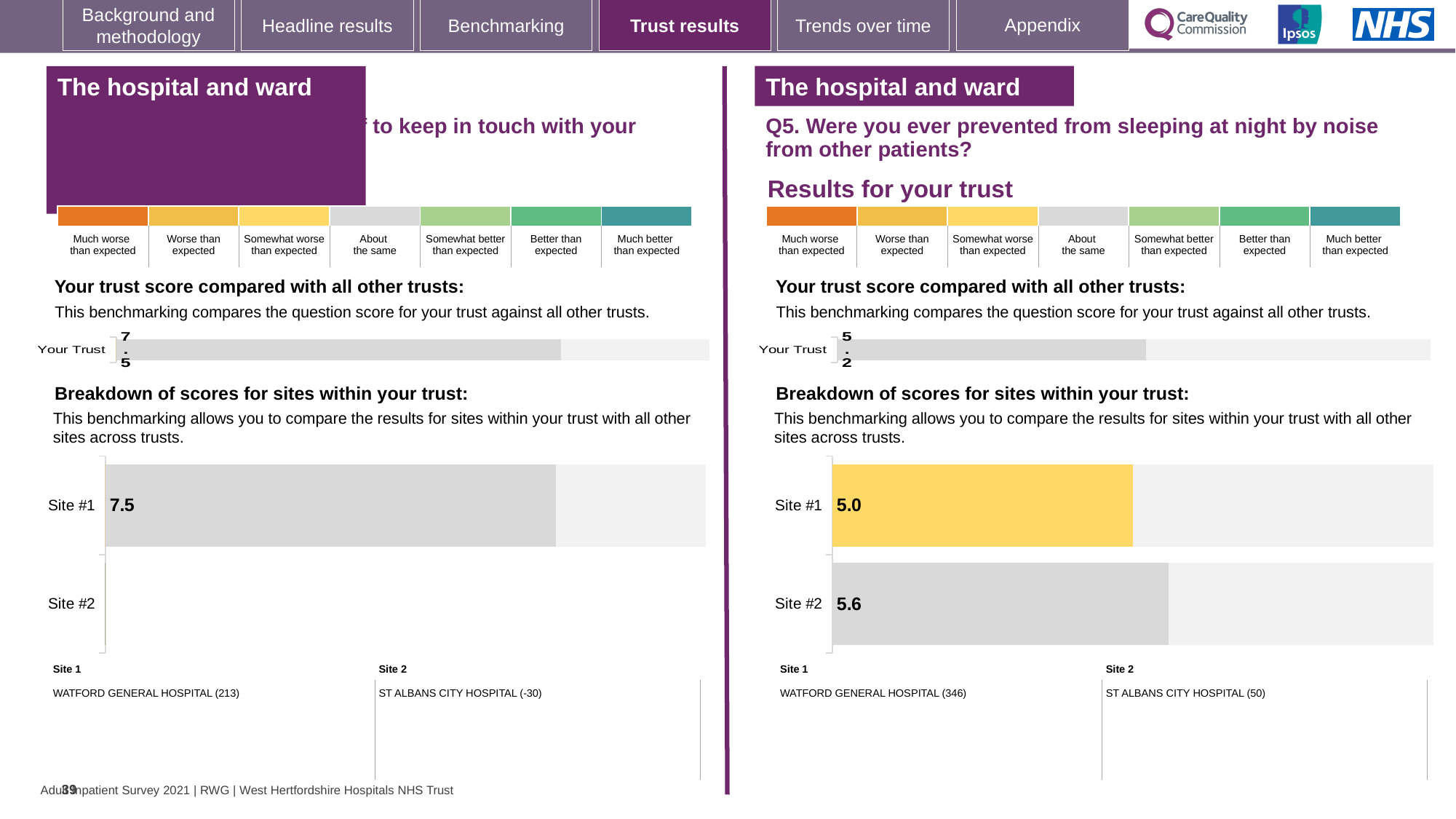
What kind of chart is used for the breakdown of scores for sites on the right-hand slide (Q5)? Bar chart On the right-hand slide (Q5), which site has the lower score in the site breakdown chart? Site #1 How many sites are listed in the site breakdown chart on the right-hand slide (Q5)? 2 On the right-hand slide (Q5), which benchmark category does the yellow colour of the Site #1 bar correspond to in the key? Somewhat worse than expected On the right-hand slide (Q5), which site has the higher score in the site breakdown chart? Site #2 On the left-hand slide, what is the score for Site #1 in the breakdown of scores for sites within your trust? 7.5 On the left-hand slide, what is the 'Your Trust' score shown in the trust score comparison chart? 7.5 On the right-hand slide (Q5), what is the score for Site #1 in the breakdown of scores for sites within your trust? 5.0 On the right-hand slide (Q5), is the score for Site #1 or Site #2 larger? Site #2 On the right-hand slide (Q5), what is the 'Your Trust' score shown in the trust score comparison chart? 5.2 On the right-hand slide (Q5), what is the difference between the Site #2 score and the Site #1 score? 0.6 On the right-hand slide (Q5), what is the score for Site #2 in the breakdown of scores for sites within your trust? 5.6